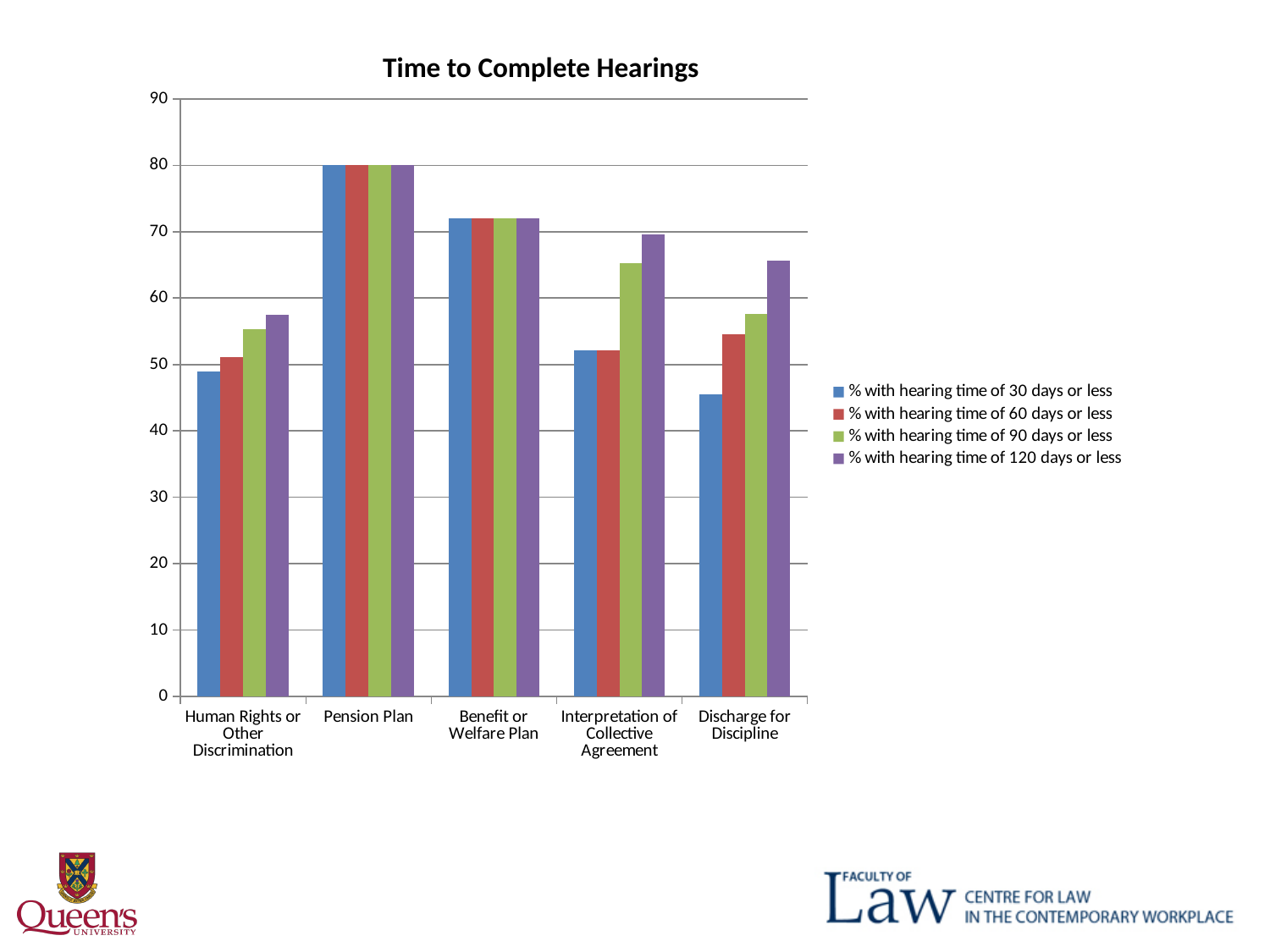
What is the value for Pension Plan in the '% with hearing time of 30 days or less' series? 80 Is the value for Interpretation of Collective Agreement in the '% with hearing time of 120 days or less' series greater or less than 60? greater Is the value for Human Rights or Other Discrimination in the '% with hearing time of 30 days or less' series greater or less than 50? less Which category has the highest value for '% with hearing time of 30 days or less'? Pension Plan For Discharge for Discipline, do the values rise or fall going from the 30 days series to the 120 days series? rise What kind of chart is shown on the slide? bar chart Is the value for Discharge for Discipline in the '% with hearing time of 60 days or less' series greater or less than 50? greater How many categories are shown on the x axis? 5 For '% with hearing time of 30 days or less', which is larger: Benefit or Welfare Plan or Discharge for Discipline? Benefit or Welfare Plan Which category has the lowest value for '% with hearing time of 30 days or less'? Discharge for Discipline What is the title of the chart? Time to Complete Hearings How many series does the legend list? 4